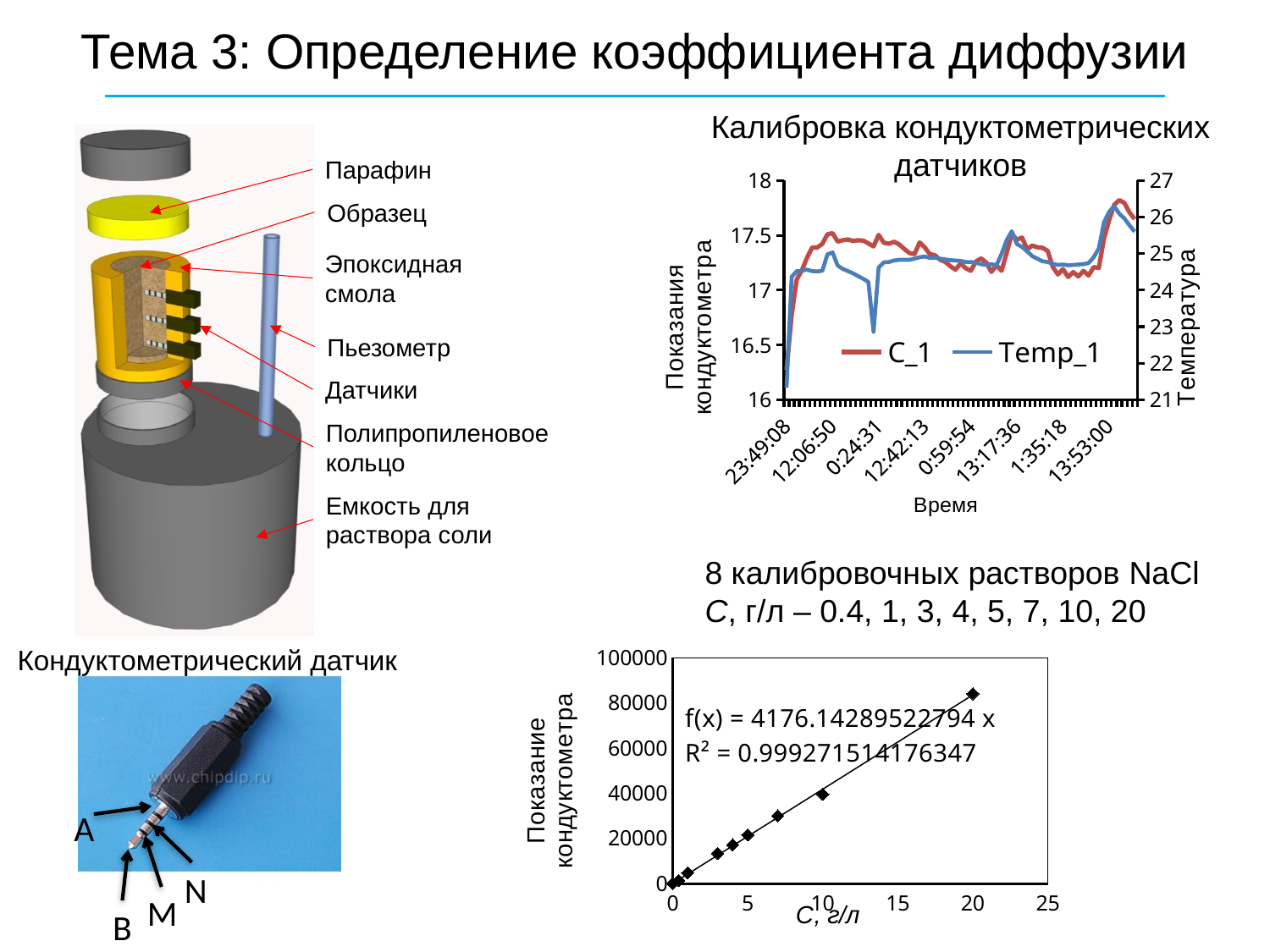
In the chart titled "Калибровка кондуктометрических датчиков", is the Temp_1 value at its sharp dip near 0:24:31 greater or less than 24? less In the chart titled "Калибровка кондуктометрических датчиков", is the C_1 value at 0:24:31 greater or less than 17? greater In the chart titled "Калибровка кондуктометрических датчиков", what are the two legend entries? C_1 and Temp_1 In the bottom-right scatter chart, what is the trendline equation shown? f(x) = 4176.14289522794 x What kind of chart is the bottom-right chart with the axis "C, г/л"? scatter chart In the bottom-right scatter chart, do the conductometer readings rise or fall as C increases? rise In the chart titled "Калибровка кондуктометрических датчиков", what is the title of the horizontal axis? Время What kind of chart is the chart titled "Калибровка кондуктометрических датчиков"? line chart In the bottom-right scatter chart, what is the R² value shown? R² = 0.999271514176347 In the bottom-right scatter chart, is the conductometer reading at C = 20 г/л greater or less than 80000? greater How many data points are plotted in the bottom-right scatter chart? 9 How many series does the legend of the chart titled "Калибровка кондуктометрических датчиков" list? 2